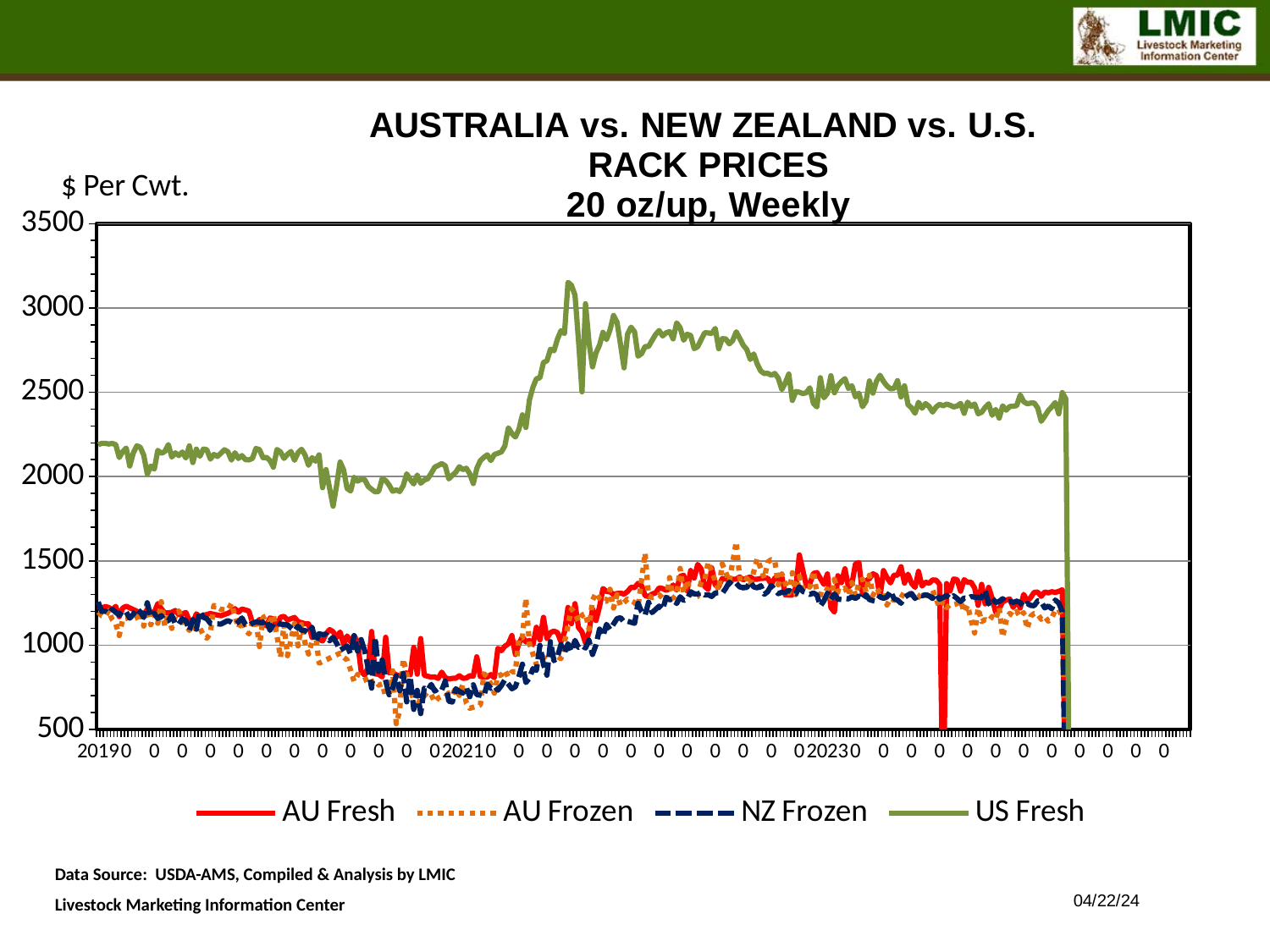
How many series does the legend list? 4 Which series has the highest prices throughout the chart? US Fresh Is the lowest value of the AU Frozen line greater or less than 1000? less Is the highest value of the AU Fresh line greater or less than 2000? less Is the lowest value of the NZ Frozen line greater or less than 1000? less At the start of the chart in 2019, which is higher, US Fresh or AU Fresh? US Fresh What is the title of the chart? AUSTRALIA vs. NEW ZEALAND vs. U.S. RACK PRICES 20 oz/up, Weekly What kind of chart is shown on the slide? line chart What unit is shown on the y axis of the chart? $ Per Cwt. From its peak in 2021 to 2023, does the US Fresh line generally rise or fall? fall